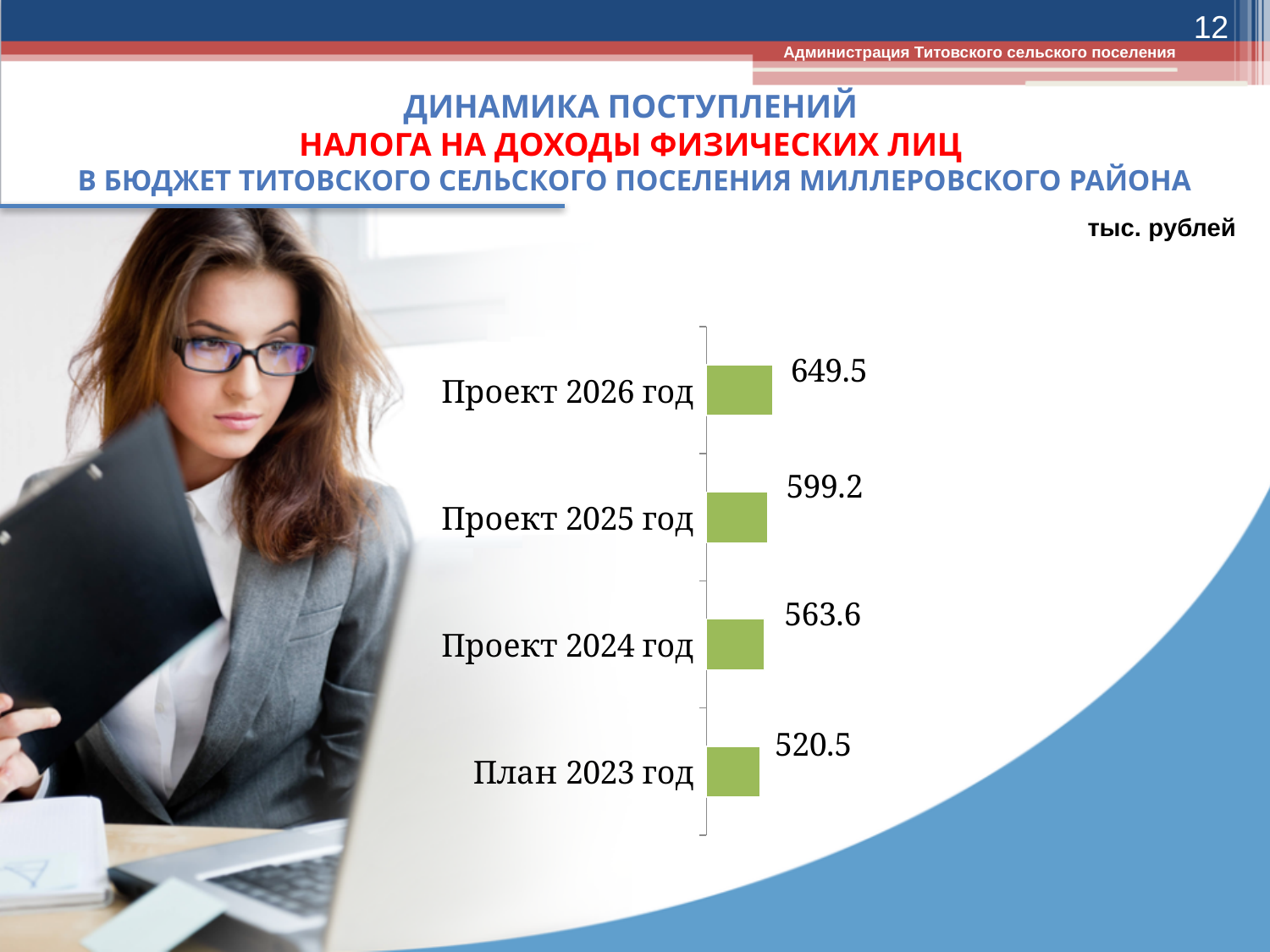
Which is larger, the value for Проект 2025 год or Проект 2024 год? Проект 2025 год How many categories does the chart show? 4 Which category has the lowest value? План 2023 год What is the difference between the values for Проект 2024 год and План 2023 год? 43.1 What is the difference between the values for Проект 2026 год and Проект 2025 год? 50.3 In what units are the chart values given, according to the slide? тыс. рублей What is the value for Проект 2025 год? 599.2 What is the value for Проект 2024 год? 563.6 Which category has the highest value? Проект 2026 год What is the value for План 2023 год? 520.5 What is the value for Проект 2026 год? 649.5 What kind of chart is shown on the slide? Bar chart